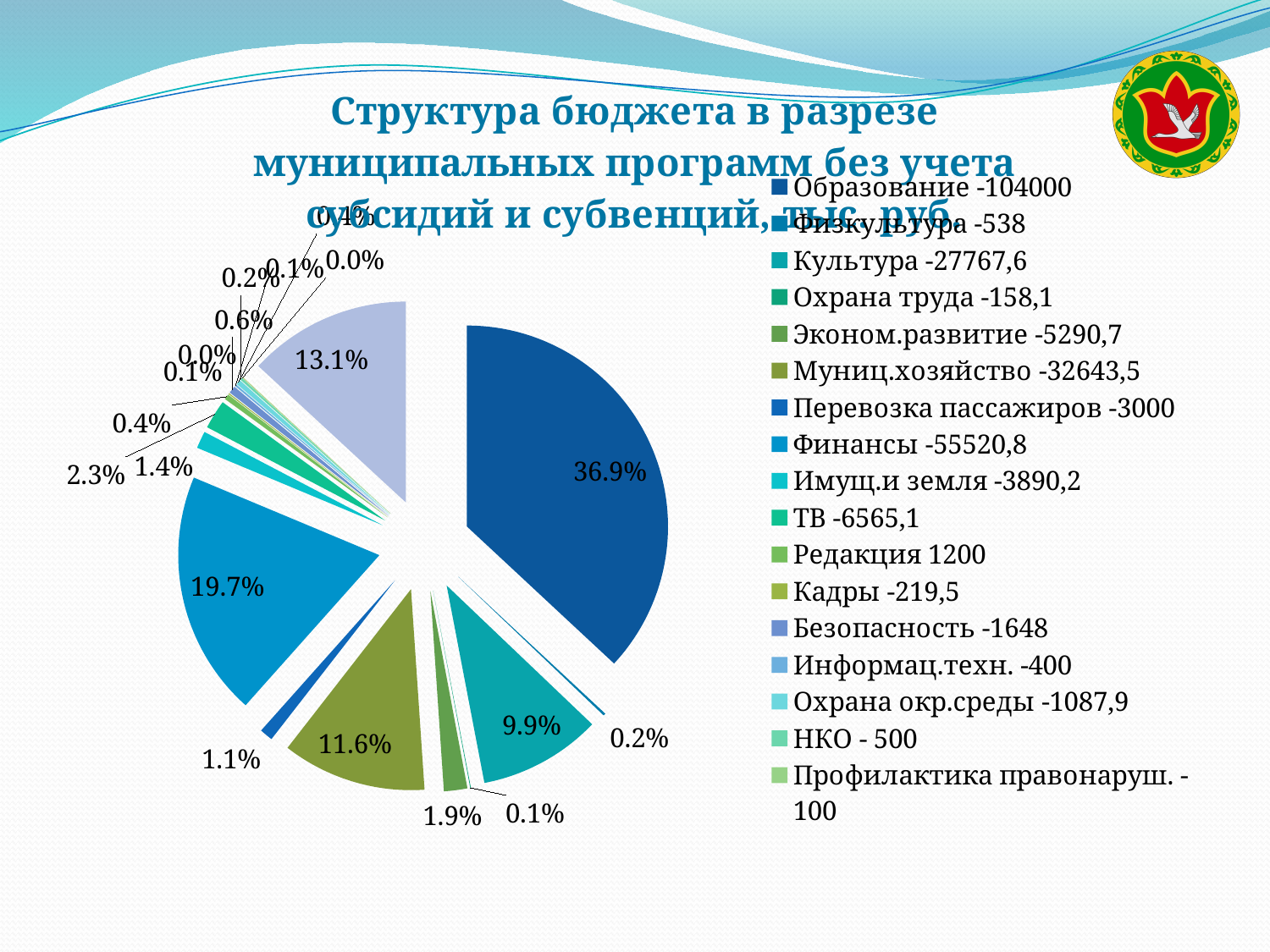
What share of the pie does Перевозка пассажиров have? 1.1% Which category has the largest slice of the pie? Образование Which has the larger share: Финансы or Муниц.хозяйство? Финансы What share of the pie does Образование have? 36.9% What share of the pie does Эконом.развитие have? 1.9% How many entries does the legend list? 17 What share of the pie does Муниц.хозяйство have? 11.6% By how many percentage points does the share of Образование exceed the share of Финансы? 17.2 percentage points What share of the pie does Культура have? 9.9% What value is given for Финансы in the legend? 55520,8 What share of the pie does Финансы have? 19.7% What type of chart is shown on the slide? pie chart